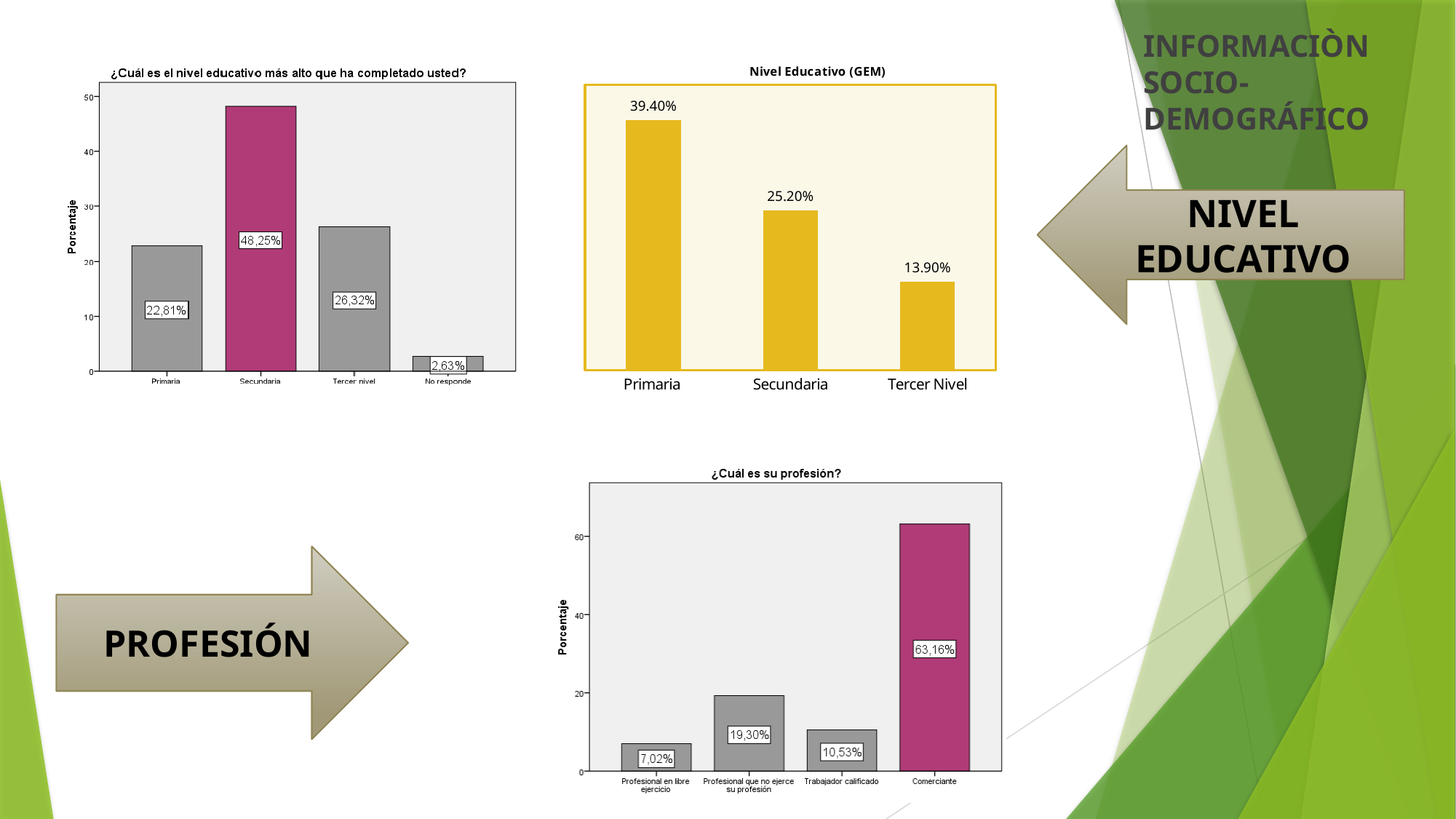
In the chart titled 'Nivel Educativo (GEM)', what is the difference between Primaria and Secundaria? 14.20 percentage points In the chart titled '¿Cuál es su profesión?', what is the value for Comerciante? 63,16% In the chart titled 'Nivel Educativo (GEM)', do the values rise or fall from left to right along the x axis? fall In the chart titled '¿Cuál es el nivel educativo más alto que ha completado usted?', how many categories are shown on the x axis? 4 In the chart titled '¿Cuál es el nivel educativo más alto que ha completado usted?', which category has the lowest value? No responde In the chart titled '¿Cuál es el nivel educativo más alto que ha completado usted?', what is the value for Secundaria? 48,25% In the chart titled 'Nivel Educativo (GEM)', which category has the highest value? Primaria In the chart titled 'Nivel Educativo (GEM)', what is the value for Primaria? 39.40% In the chart titled '¿Cuál es su profesión?', which is larger: Profesional que no ejerce su profesión or Trabajador calificado? Profesional que no ejerce su profesión In the chart titled '¿Cuál es el nivel educativo más alto que ha completado usted?', what is the difference between Secundaria and Tercer nivel? 21,93 percentage points In the chart titled '¿Cuál es su profesión?', is the value for Comerciante greater or less than 60? greater What kind of chart is the one titled '¿Cuál es su profesión?'? bar chart